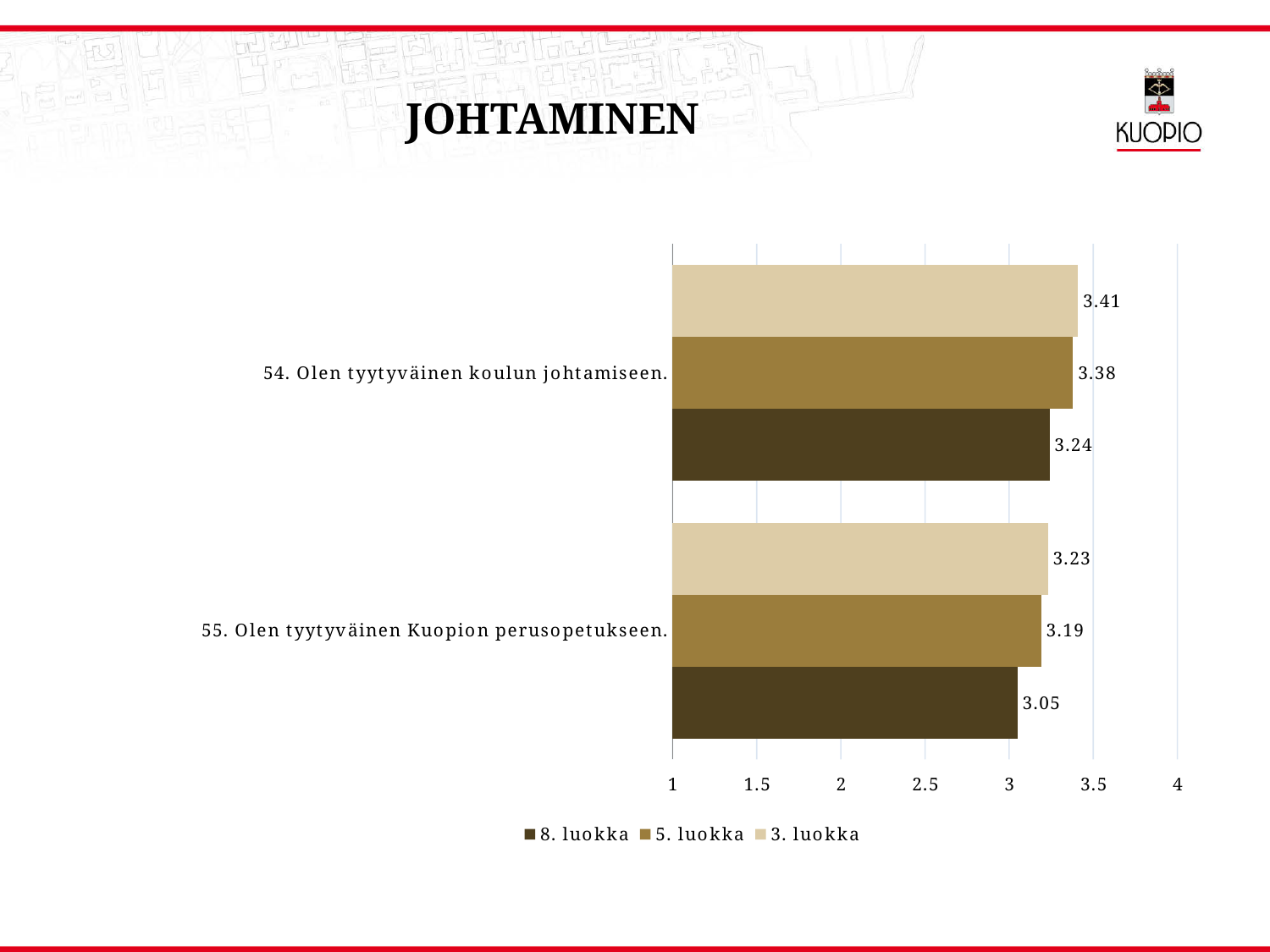
Which series has the lowest value for statement 55 (Olen tyytyväinen Kuopion perusopetukseen)? 8. luokka What is the difference between the 3. luokka and 8. luokka values for statement 54 (Olen tyytyväinen koulun johtamiseen)? 0.17 What is the value for 3. luokka for statement 55 (Olen tyytyväinen Kuopion perusopetukseen)? 3.23 What is the value for 5. luokka for statement 54 (Olen tyytyväinen koulun johtamiseen)? 3.38 Which series has the highest value for statement 54 (Olen tyytyväinen koulun johtamiseen)? 3. luokka What is the title of the slide containing the chart? JOHTAMINEN What is the value for 3. luokka for statement 54 (Olen tyytyväinen koulun johtamiseen)? 3.41 How many series does the legend list? 3 What kind of chart is shown on the slide? bar chart What is the value for 8. luokka for statement 55 (Olen tyytyväinen Kuopion perusopetukseen)? 3.05 How many categories (statements) are plotted in the chart? 2 Which is larger: the 5. luokka value for statement 54 or the 5. luokka value for statement 55? statement 54 (3.38)